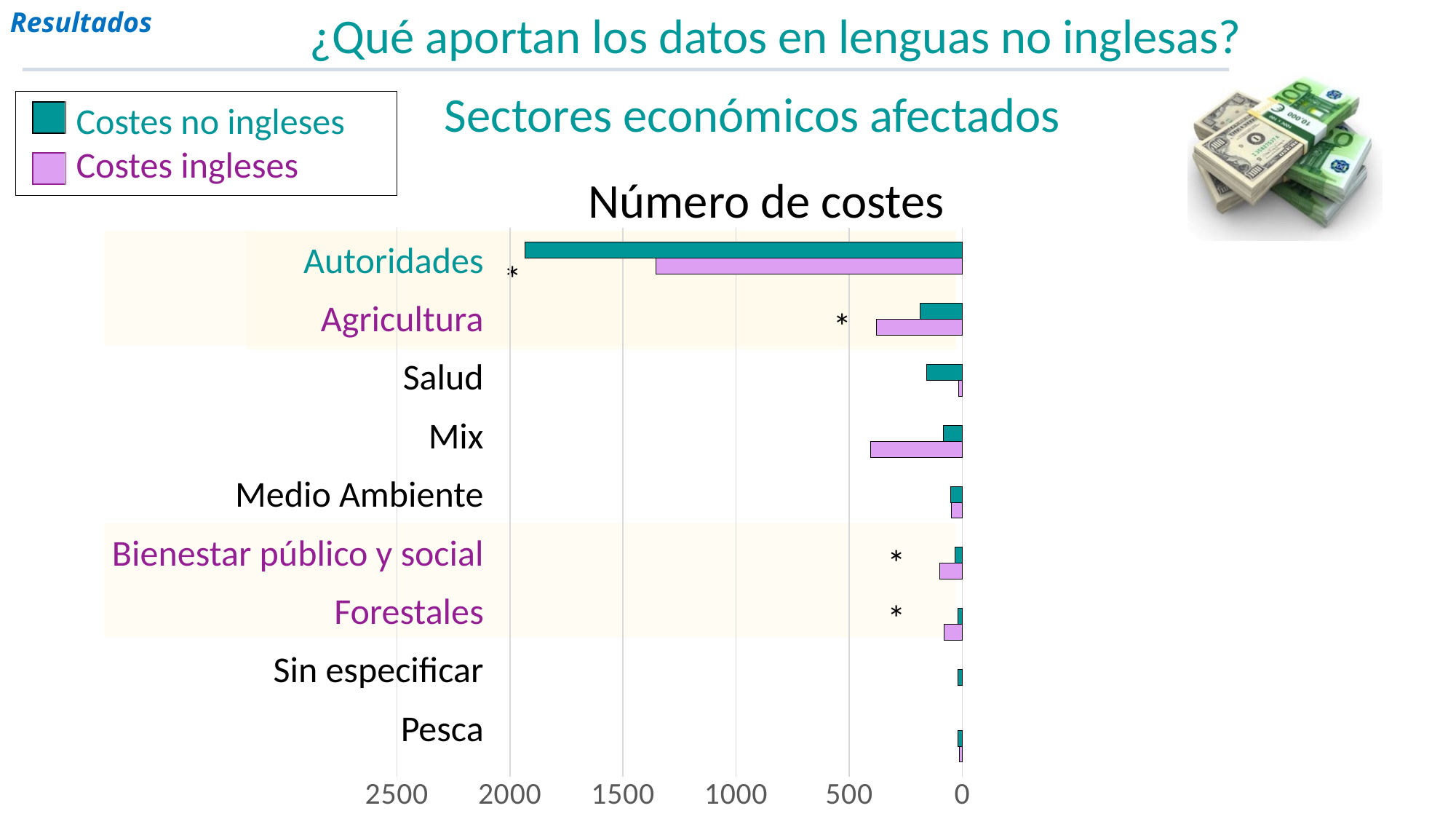
Which sector has the highest value for 'Costes ingleses'? Autoridades How many series does the legend list? 2 For Autoridades, which is larger: 'Costes no ingleses' or 'Costes ingleses'? Costes no ingleses Is the 'Costes ingleses' value for Autoridades greater or less than 1000? greater How many economic sectors (categories) are listed on the chart? 9 Is the 'Costes no ingleses' value for Autoridades greater or less than 1500? greater What kind of chart is shown under the title 'Número de costes'? bar chart Is the 'Costes ingleses' value for Agricultura greater or less than 500? less What is the title of the chart? Número de costes For Salud, which is larger: 'Costes no ingleses' or 'Costes ingleses'? Costes no ingleses Which sector has the highest value for 'Costes no ingleses'? Autoridades For Mix, which is larger: 'Costes no ingleses' or 'Costes ingleses'? Costes ingleses